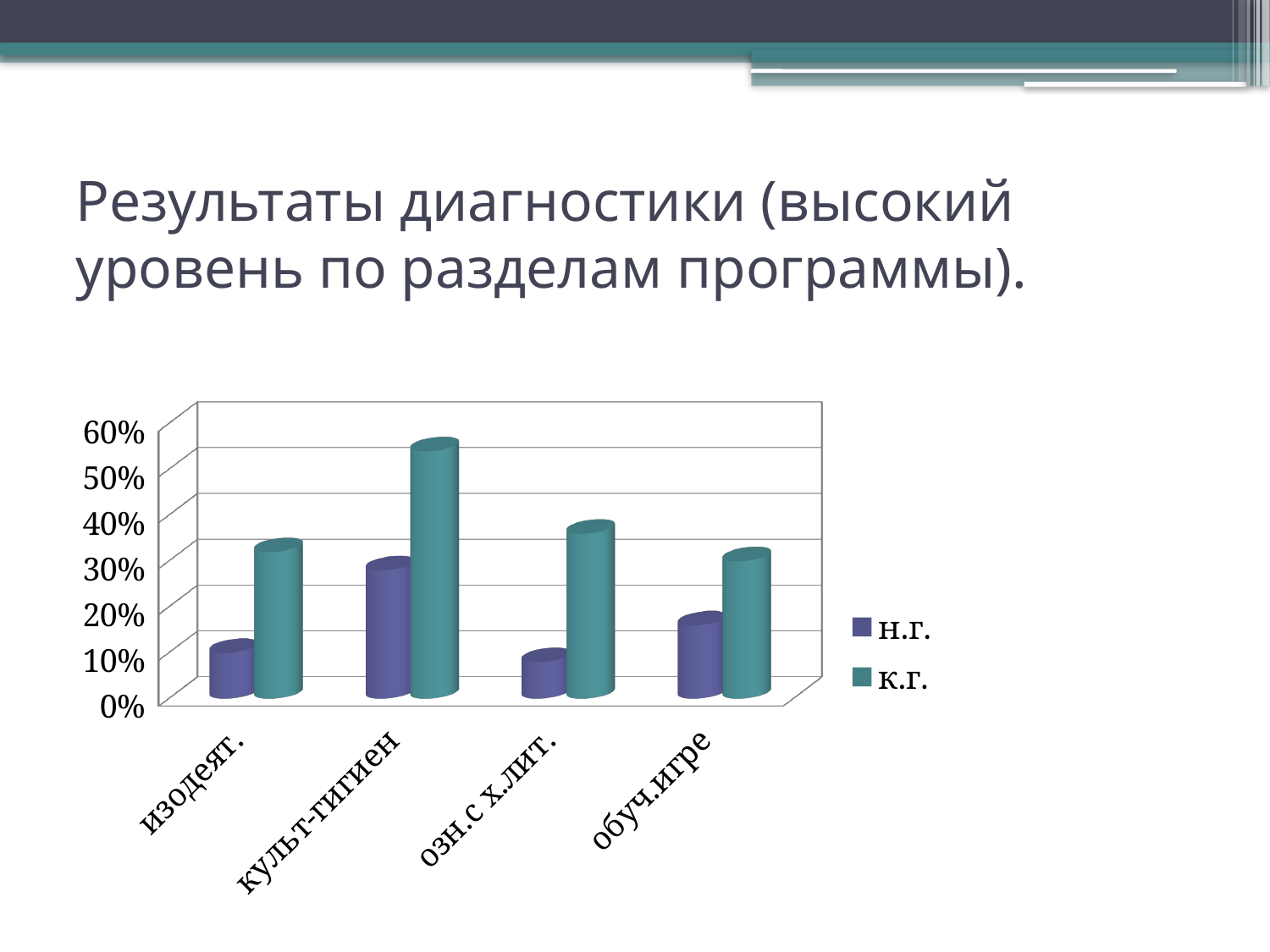
What are the two legend entries of the chart? н.г. and к.г. How many series does the legend list? 2 Is the н.г. value for обуч.игре greater or less than 30%? less Which category has the highest value for the к.г. series? культ-гигиен What kind of chart is shown on the slide? bar chart For изодеят., which series has the larger value, н.г. or к.г.? к.г. How many categories are shown on the x axis? 4 Which category has the highest value for the н.г. series? культ-гигиен For обуч.игре, which series has the larger value, н.г. or к.г.? к.г. Is the н.г. value for изодеят. greater or less than 20%? less Is the к.г. value for культ-гигиен greater or less than 50%? greater